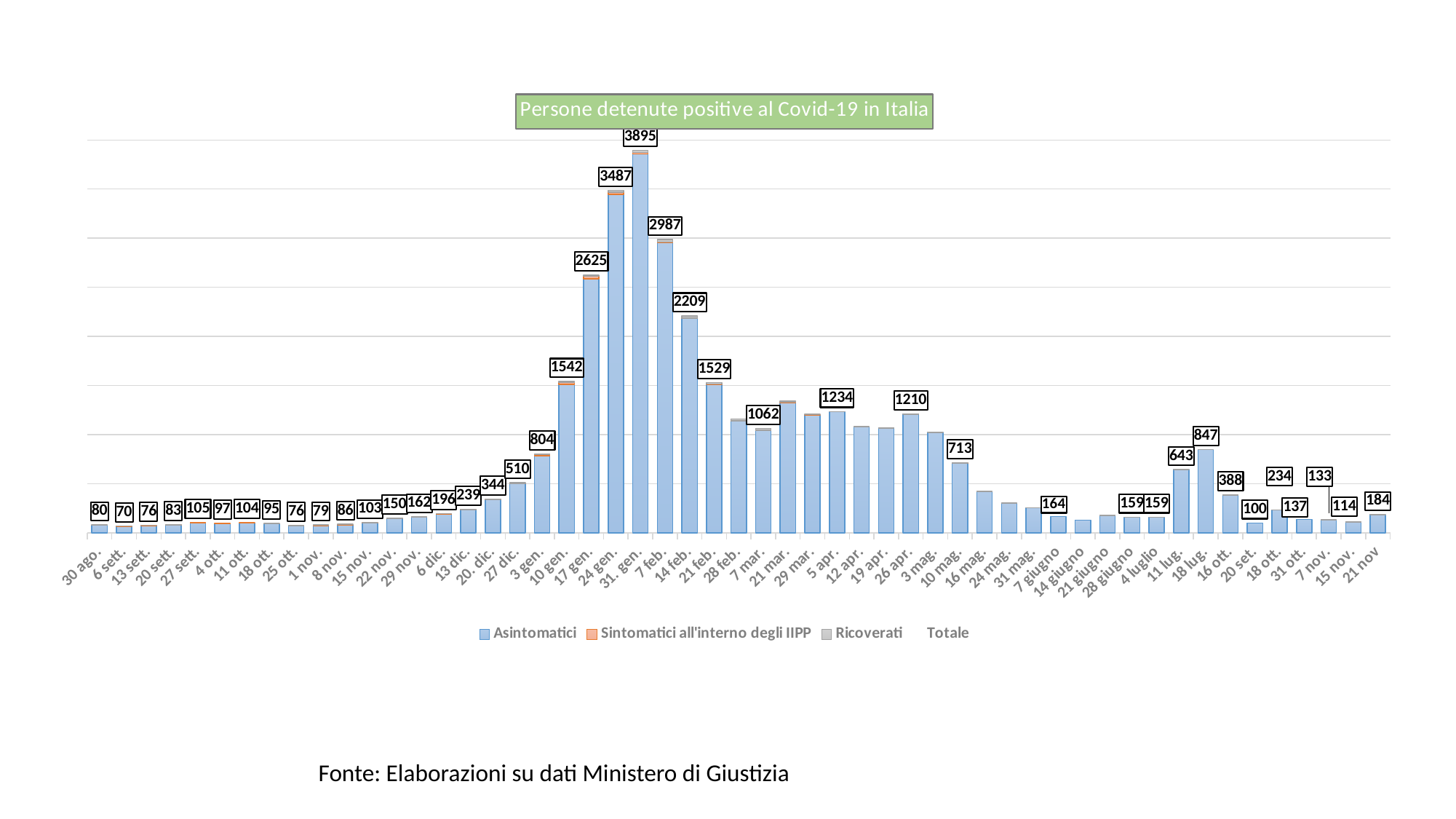
What is the difference between the totals for 7 feb. and 14 feb.? 778 What is the difference between the totals for 31 gen. and 24 gen.? 408 Do the totals rise or fall from 6 dic. to 31 gen.? Rise Which date has the highest total of positive detainees? 31 gen. What is the total value shown for 31 gen.? 3895 Which is larger, the total for 11 lug. or the total for 16 ott.? 11 lug. What kind of chart is shown on the slide? Bar chart How many series does the legend list? 4 What is the total value shown for 10 gen.? 1542 What is the total value shown for 18 lug.? 847 Which is larger, the total for 24 gen. or the total for 7 feb.? 24 gen. What is the total value shown for 7 giugno? 164